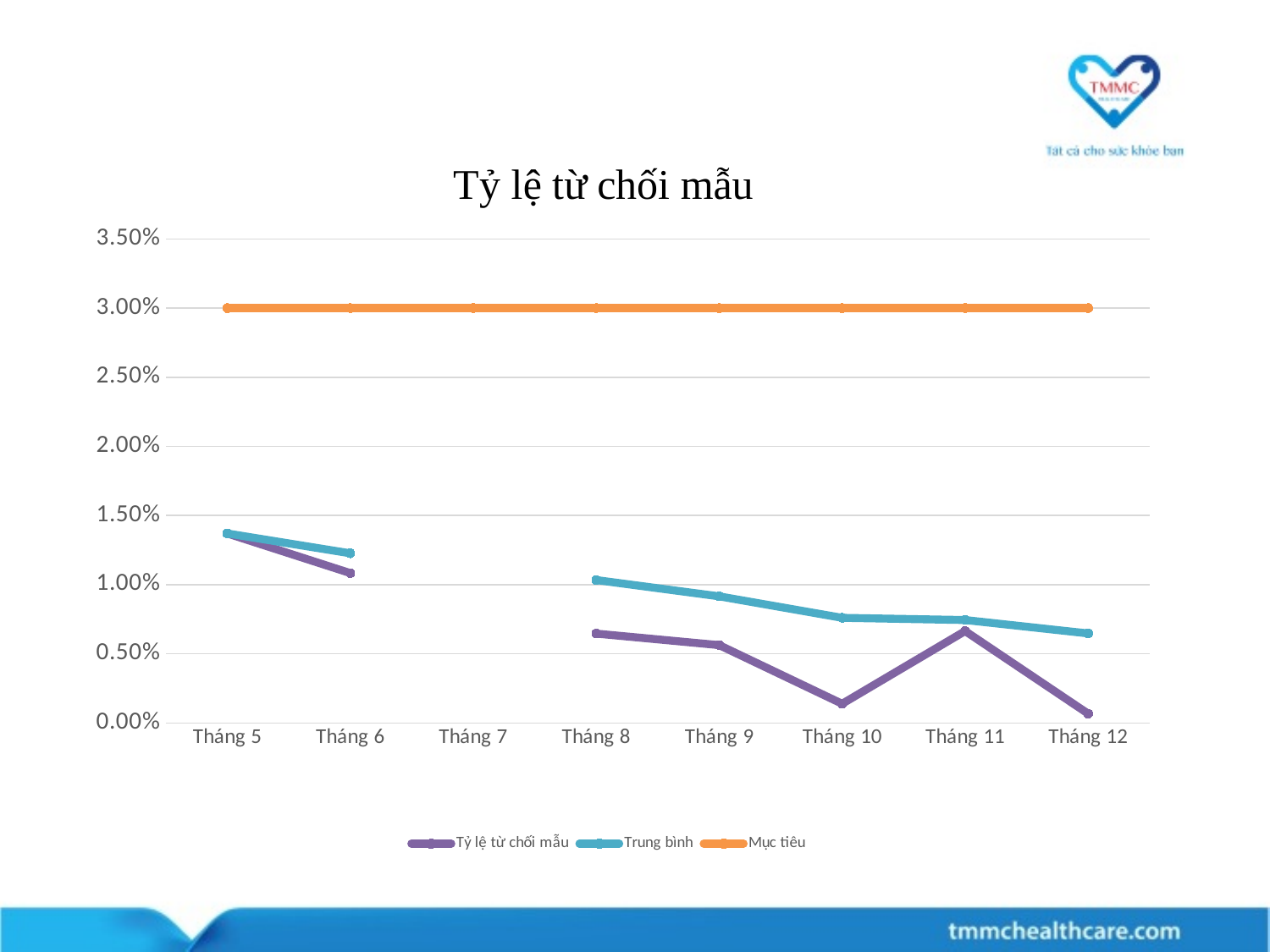
How many months are shown on the x axis? 8 How many series does the legend list? 3 In Tháng 9, which is larger: Tỷ lệ từ chối mẫu or Trung bình? Trung bình What is the value of the Mục tiêu series in Tháng 8? 3.00% Is the value of Trung bình in Tháng 5 greater or less than 1.00%? greater Is the value of Tỷ lệ từ chối mẫu in Tháng 10 greater or less than 0.50%? less Which series is drawn in orange? Mục tiêu What is the title of the chart? Tỷ lệ từ chối mẫu In which month is the Trung bình series highest? Tháng 5 Does the Mục tiêu series rise, fall or stay flat from Tháng 5 to Tháng 12? Stays flat In which month is the Tỷ lệ từ chối mẫu series highest? Tháng 5 What kind of chart is shown on the slide? Line chart